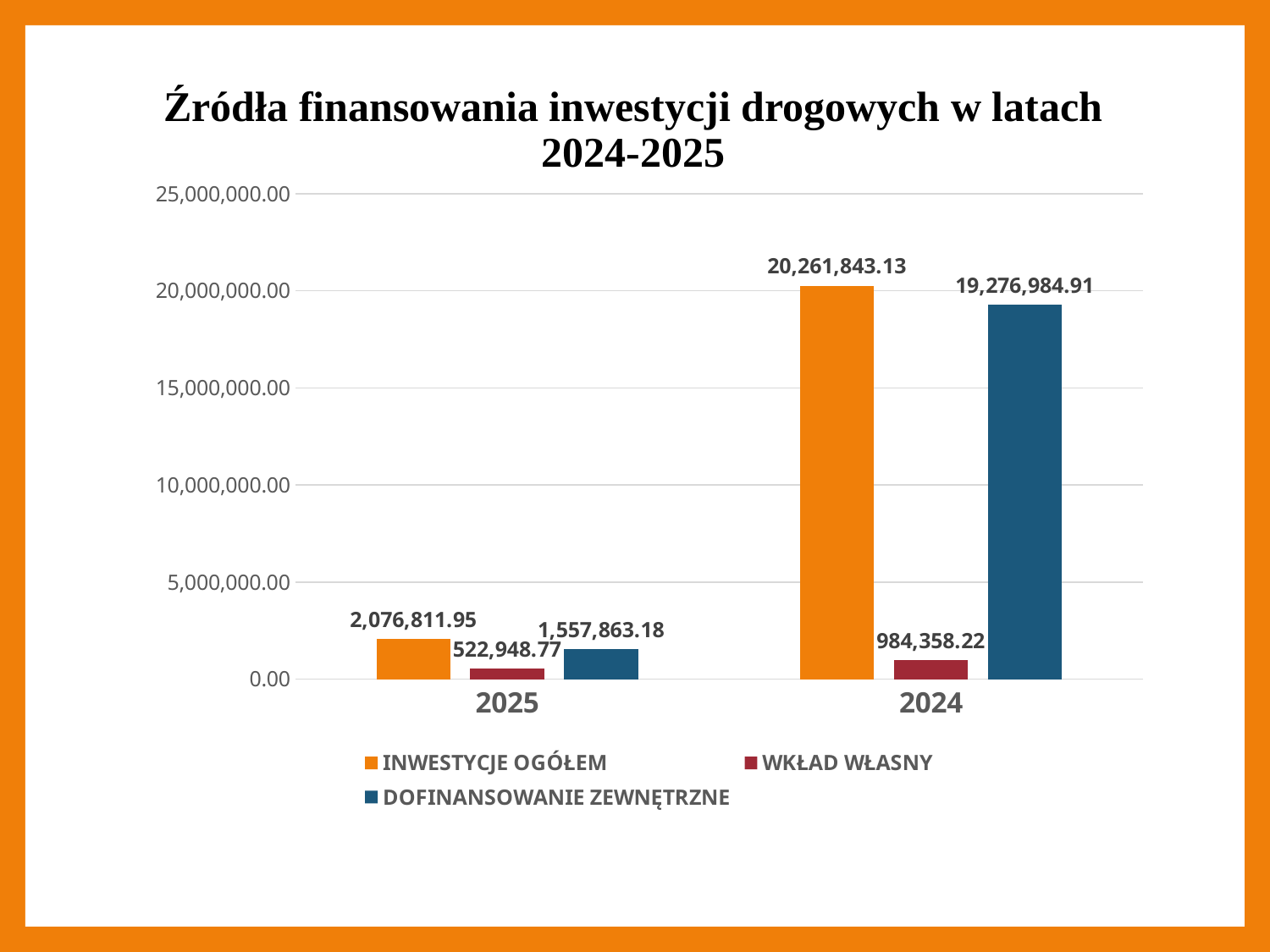
What is the value of INWESTYCJE OGÓŁEM for 2024? 20,261,843.13 Is the value of DOFINANSOWANIE ZEWNĘTRZNE for 2024 greater or less than 15,000,000.00? greater How many series does the legend list? 3 What is the difference between WKŁAD WŁASNY in 2024 and in 2025? 461,409.45 What is the value of DOFINANSOWANIE ZEWNĘTRZNE for 2025? 1,557,863.18 What is the difference between INWESTYCJE OGÓŁEM in 2024 and in 2025? 18,185,031.18 Which year has the higher value of INWESTYCJE OGÓŁEM? 2024 What is the value of WKŁAD WŁASNY for 2025? 522,948.77 Which series has the lowest value in 2024? WKŁAD WŁASNY What is the value of DOFINANSOWANIE ZEWNĘTRZNE for 2024? 19,276,984.91 What is the title of the chart? Źródła finansowania inwestycji drogowych w latach 2024-2025 What kind of chart is shown on the slide? bar chart